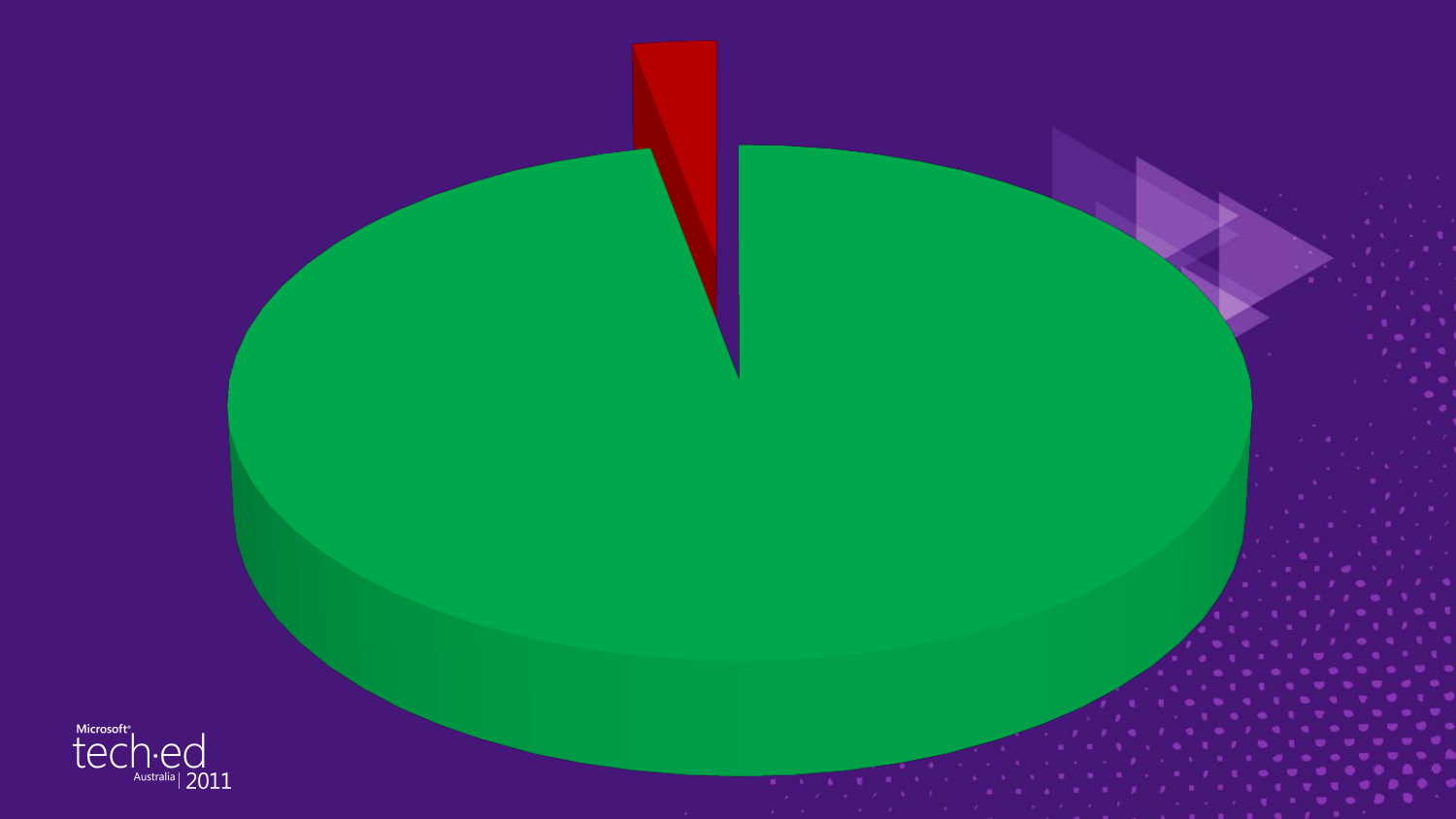
What kind of chart is shown on the slide? pie chart Does the green slice take up more or less than half of the pie? more Does the pie chart have a legend? no How many slices does the pie chart have? 2 Which slice of the pie chart is the largest? the green slice What colour is the small slice of the pie chart? red Which slice of the pie chart is the smallest? the red slice Which is larger, the green slice or the red slice? the green slice